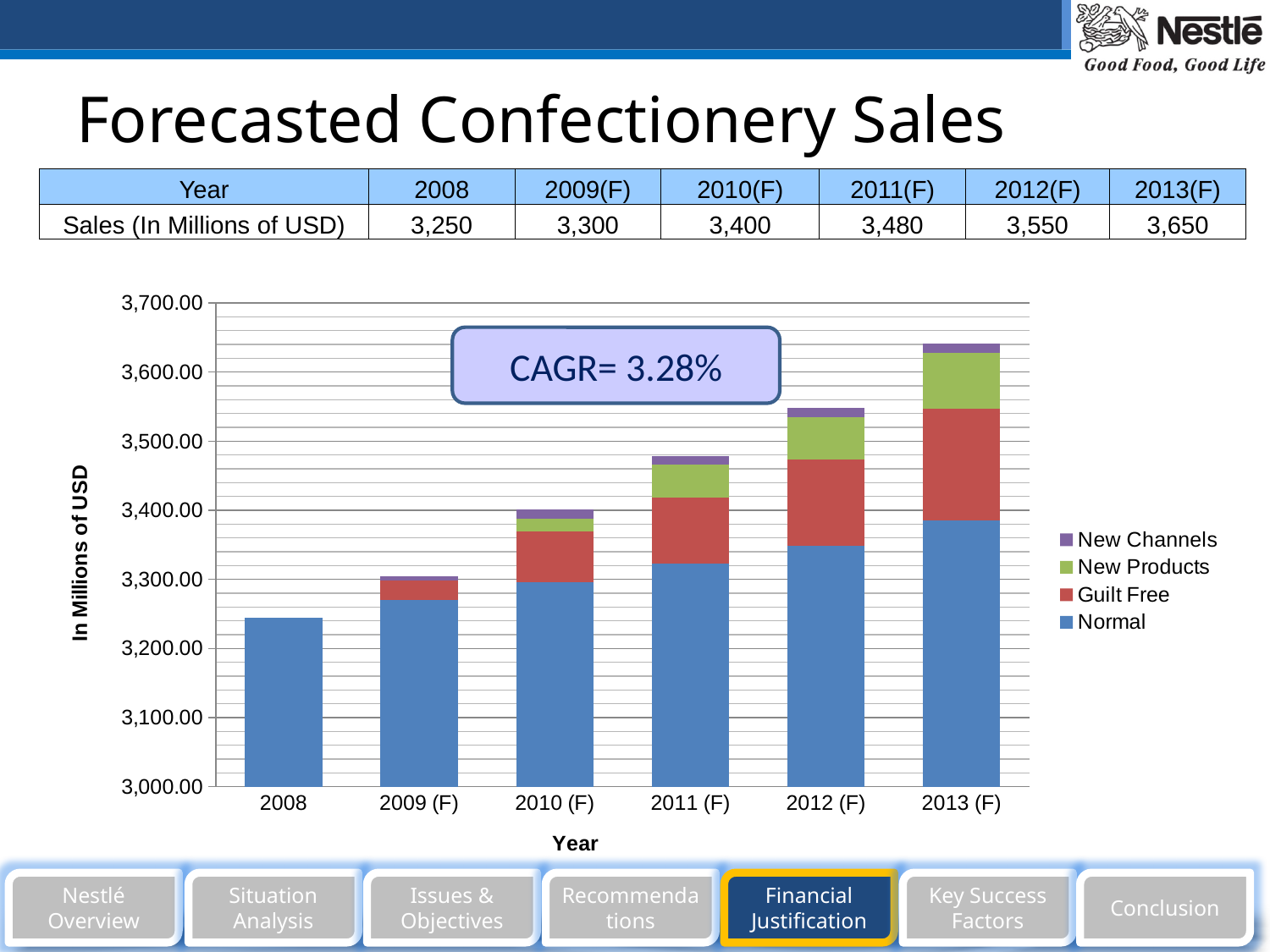
How many years are plotted along the x axis of the chart? 6 Is the total bar for 2013 (F) greater or less than 3,600.00? greater How many series does the chart legend list? 4 Is the total bar for 2011 (F) greater or less than 3,500.00? less Which year has the shortest stacked bar in the chart? 2008 Which year has the tallest stacked bar in the chart? 2013 (F) Do the total bar heights rise or fall from 2008 to 2013 (F)? rise Which series is shown in purple at the top of the stacked bars? New Channels Is the Normal segment for 2013 (F) greater or less than 3,400.00? less What kind of chart is shown on the slide? stacked bar chart What CAGR value is annotated on the chart? 3.28%